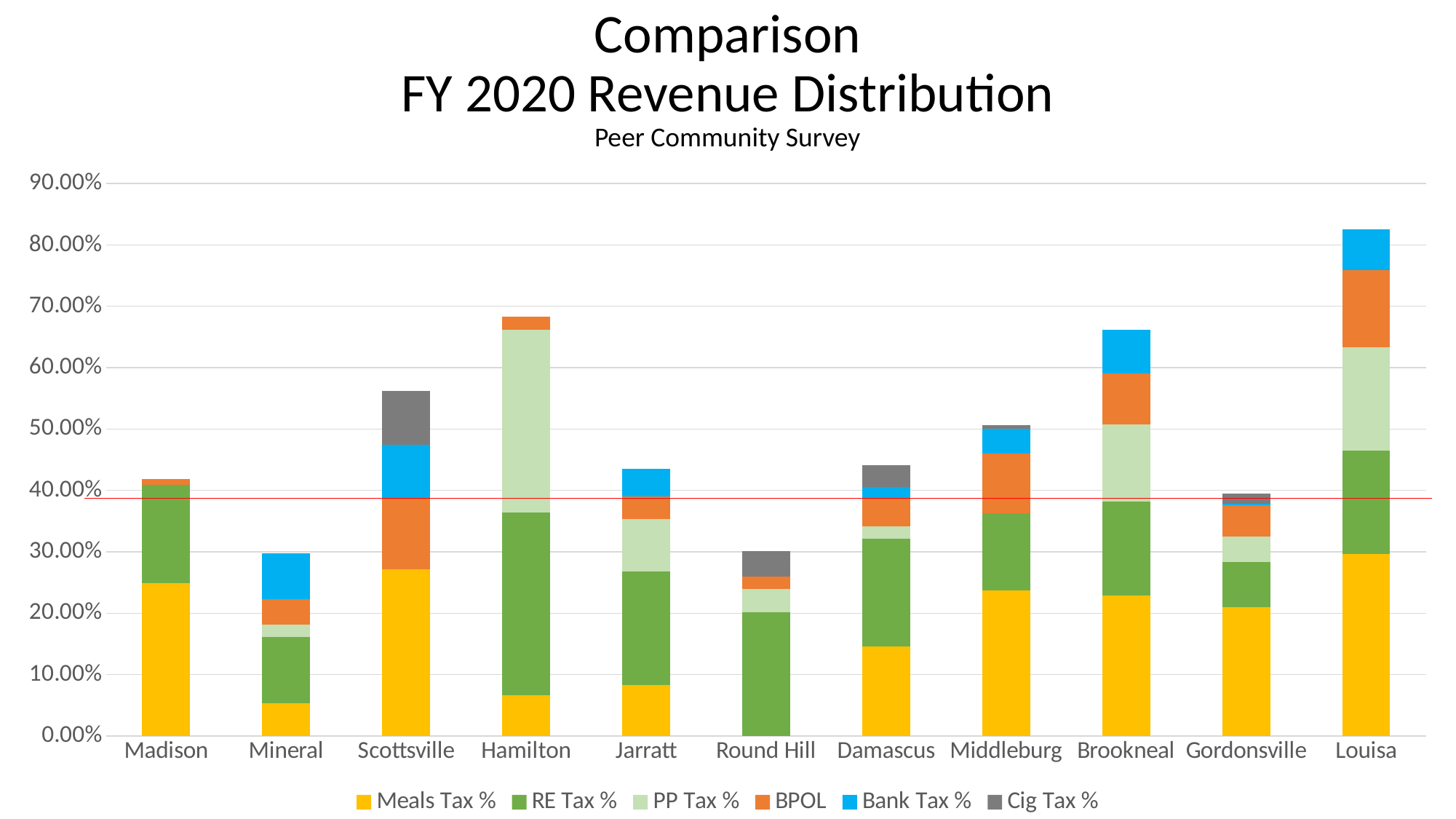
Which has the larger Meals Tax % segment, Madison or Mineral? Madison Which has the larger total stacked bar, Hamilton or Scottsville? Hamilton What kind of chart is shown on the slide? Stacked bar chart Is the total stacked value for Round Hill greater or less than 40.00%? less Is the total stacked value for Hamilton greater or less than 60.00%? greater Which community has the highest total stacked bar? Louisa Is the total stacked value for Louisa greater or less than 80.00%? greater What is the subtitle shown below the chart title? Peer Community Survey Which community's bar has no Meals Tax % segment? Round Hill How many series does the chart's legend list? 6 How many communities are shown on the x axis of the chart? 11